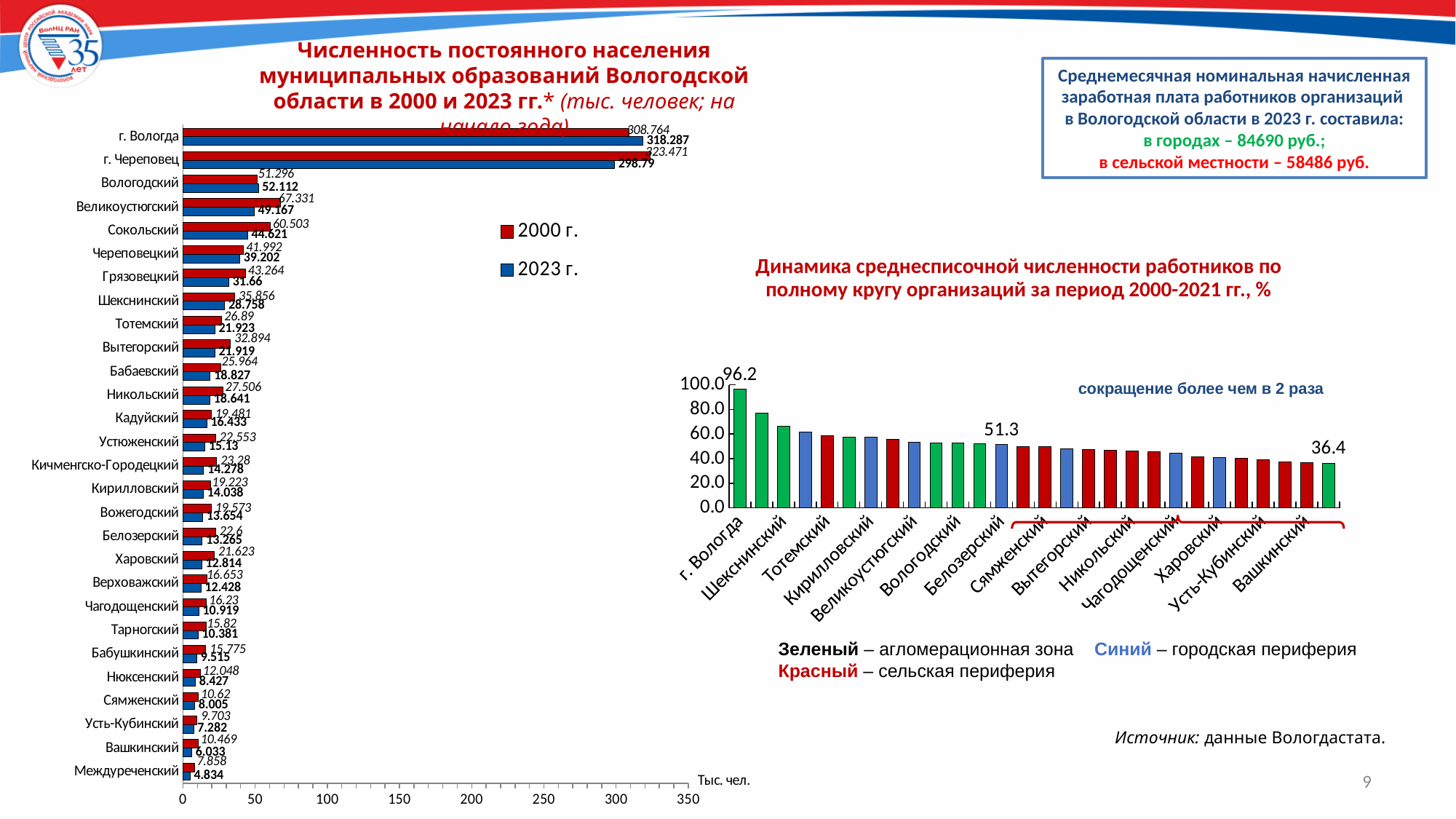
In the chart 'Численность постоянного населения муниципальных образований Вологодской области в 2000 и 2023 гг.', which municipality has the lowest 2023 г. value? Междуреченский What kind of chart is 'Динамика среднесписочной численности работников по полному кругу организаций за период 2000-2021 гг., %'? Bar chart In the chart 'Динамика среднесписочной численности работников по полному кругу организаций за период 2000-2021 гг., %', is the value for Тотемский greater or less than 80.0? less In the chart 'Динамика среднесписочной численности работников по полному кругу организаций за период 2000-2021 гг., %', what is the value for г. Вологда? 96.2 In the chart 'Численность постоянного населения муниципальных образований Вологодской области в 2000 и 2023 гг.', which municipality has the highest 2000 г. value? г. Череповец In the chart 'Численность постоянного населения муниципальных образований Вологодской области в 2000 и 2023 гг.', how many series does the legend list? 2 In the chart 'Численность постоянного населения муниципальных образований Вологодской области в 2000 и 2023 гг.', what is the 2023 г. value for Сокольский? 44.621 In the chart 'Численность постоянного населения муниципальных образований Вологодской области в 2000 и 2023 гг.', what is the difference between the 2000 г. and 2023 г. values for Великоустюгский? 18.164 In the chart 'Численность постоянного населения муниципальных образований Вологодской области в 2000 и 2023 гг.', how many municipalities are shown? 28 In the chart 'Численность постоянного населения муниципальных образований Вологодской области в 2000 и 2023 гг.', what is the 2023 г. value for г. Вологда? 318.287 In the chart 'Численность постоянного населения муниципальных образований Вологодской области в 2000 и 2023 гг.', which is larger for Вологодский: the 2000 г. value or the 2023 г. value? 2023 г. In the chart 'Численность постоянного населения муниципальных образований Вологодской области в 2000 и 2023 гг.', what is the 2000 г. value for г. Череповец? 323.471